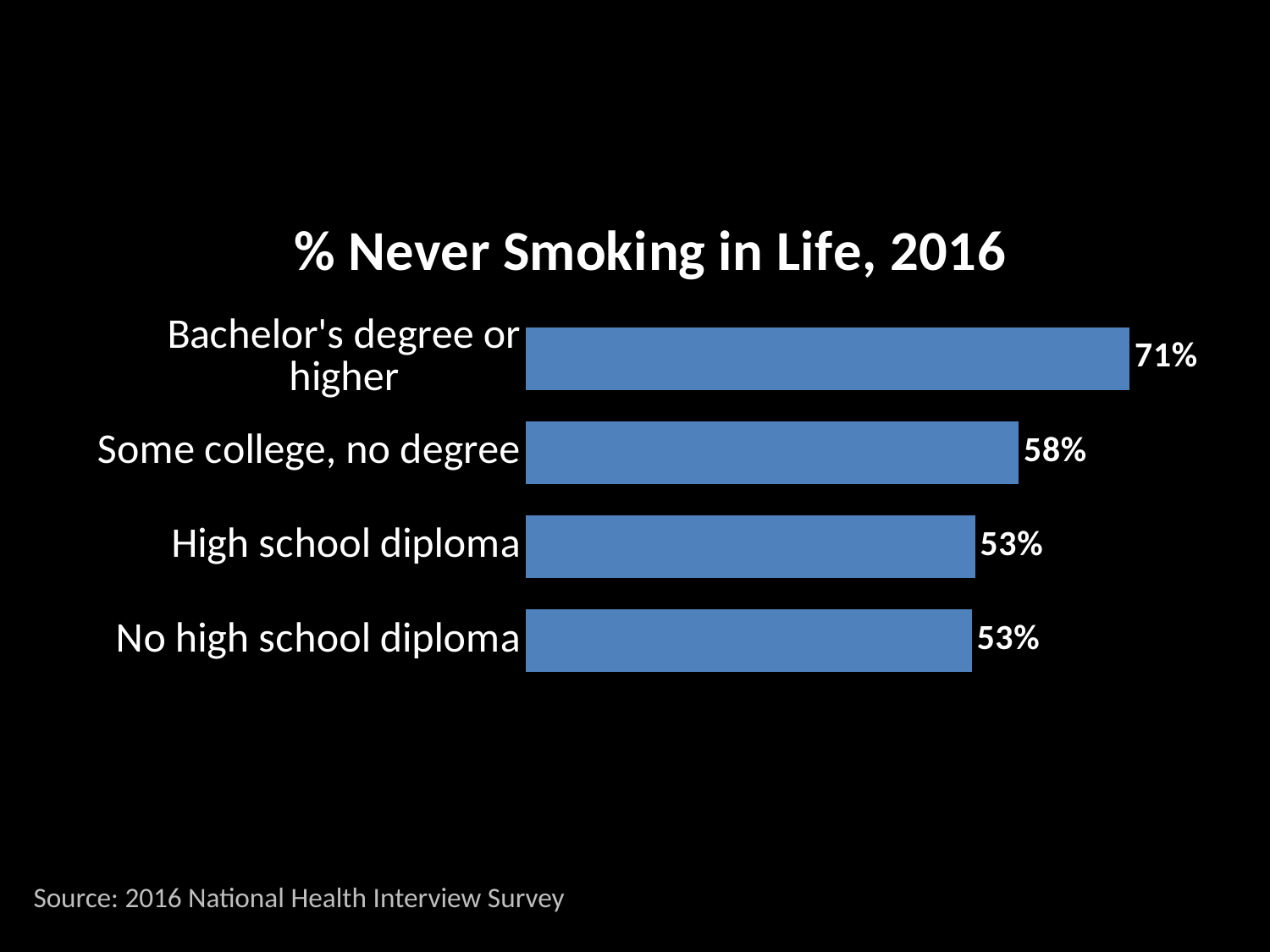
What is the value for Bachelor's degree or higher? 71% What is the value for No high school diploma? 53% What is the value for Some college, no degree? 58% Which category has the highest value? Bachelor's degree or higher Which is larger, the value for Bachelor's degree or higher or the value for High school diploma? Bachelor's degree or higher What source is cited for the chart? 2016 National Health Interview Survey What is the title of the chart? % Never Smoking in Life, 2016 What is the difference between the values for Bachelor's degree or higher and Some college, no degree? 13% What kind of chart is shown on the slide? Bar chart What is the value for High school diploma? 53% How many categories are shown in the chart? 4 What is the difference between the values for Some college, no degree and High school diploma? 5%